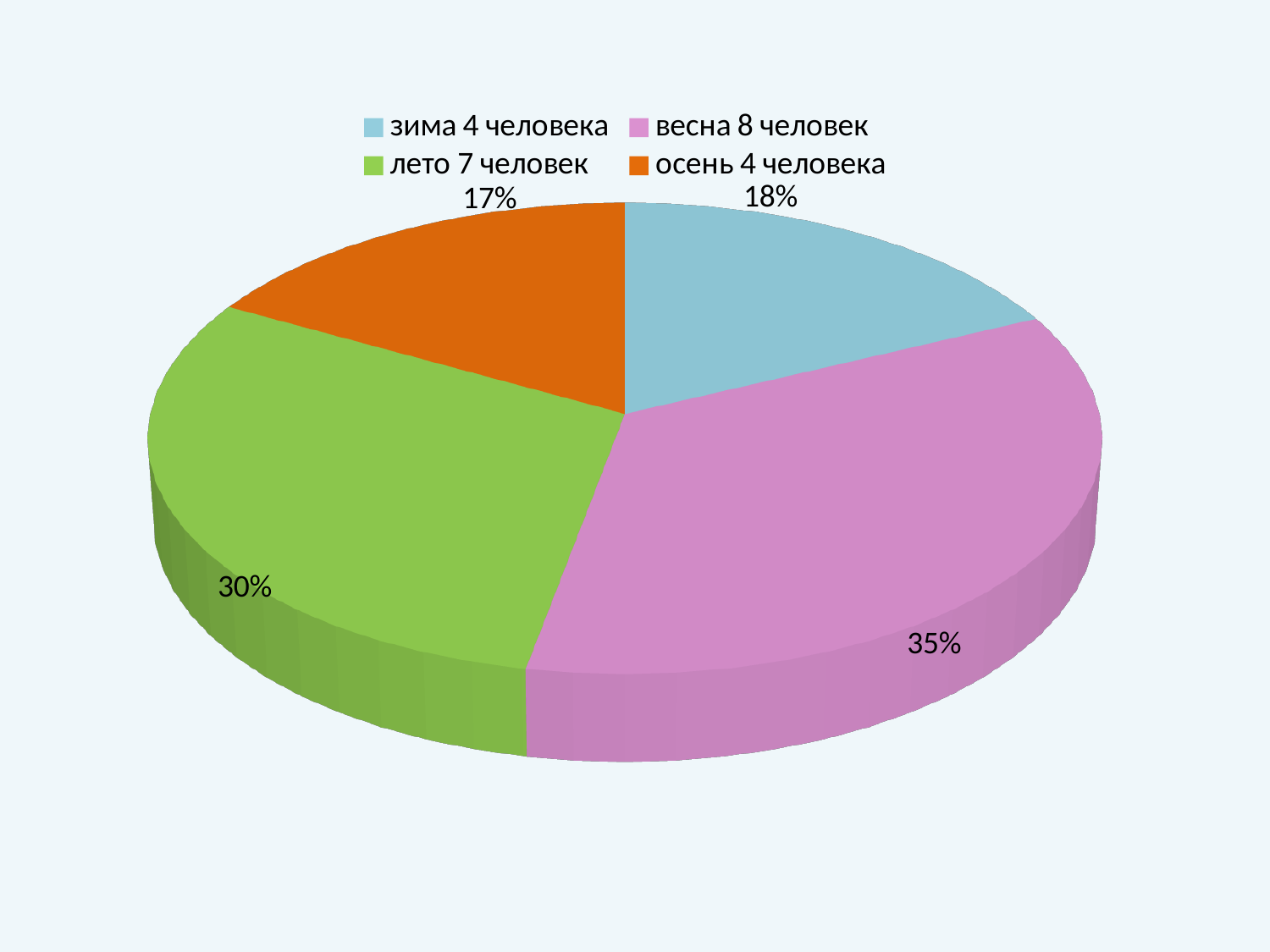
Which slice of the pie is the largest? весна 8 человек What percentage is shown for the "лето 7 человек" slice? 30% What percentage of the pie does the slice for "весна 8 человек" represent? 35% How many slices does the pie chart have? 4 What colour is the "весна 8 человек" slice? pink According to the legend, how many people are in the "лето" category? 7 What kind of chart is shown on the slide? pie chart Which slice is larger, "лето 7 человек" or "зима 4 человека"? лето 7 человек What is the difference in percentage points between the "весна" slice and the "лето" slice? 5 What percentage is shown for the "зима 4 человека" slice? 18% What percentage is shown for the "осень 4 человека" slice? 17% Which slice of the pie is the smallest? осень 4 человека